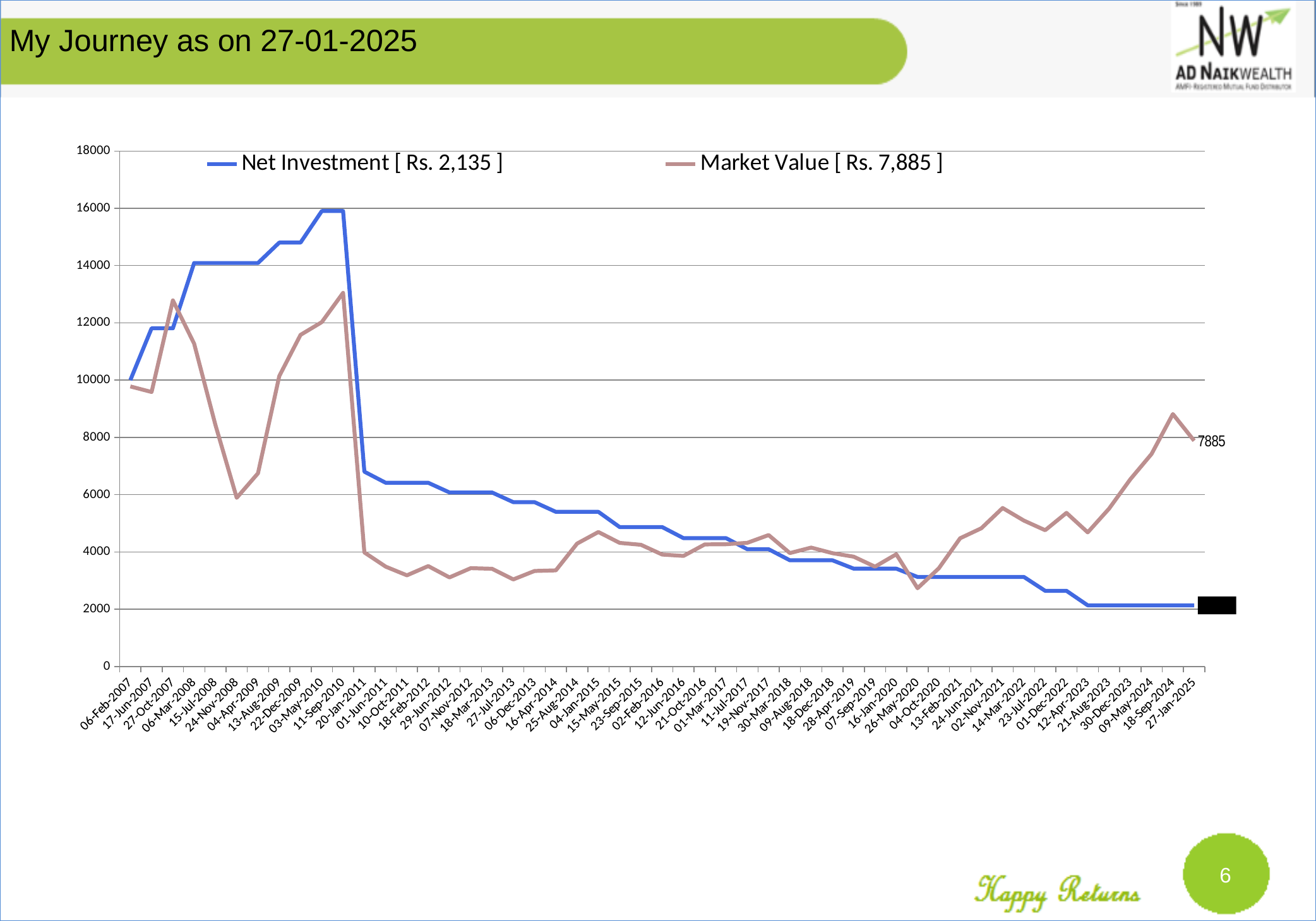
What Net Investment amount is given in the legend? Rs. 2,135 What is the difference between the Market Value (Rs. 7,885) and the Net Investment (Rs. 2,135) shown in the legend? Rs. 5,750 On 27-Jan-2025, which is larger: Net Investment or Market Value? Market Value How many series does the chart's legend list? 2 Is the Net Investment value on 11-Sep-2010 greater or less than 14000? greater Which series reaches the highest point anywhere on the chart? Net Investment What kind of chart is shown on the slide? line chart What is the Market Value on 27-Jan-2025, as labelled on the chart? 7885 What Market Value amount is given in the legend? Rs. 7,885 Is the Market Value on 24-Nov-2008 greater or less than 8000? less Is the Market Value on 18-Sep-2024 greater or less than 8000? greater Does the Net Investment line generally rise or fall from 20-Jan-2011 to 27-Jan-2025? fall